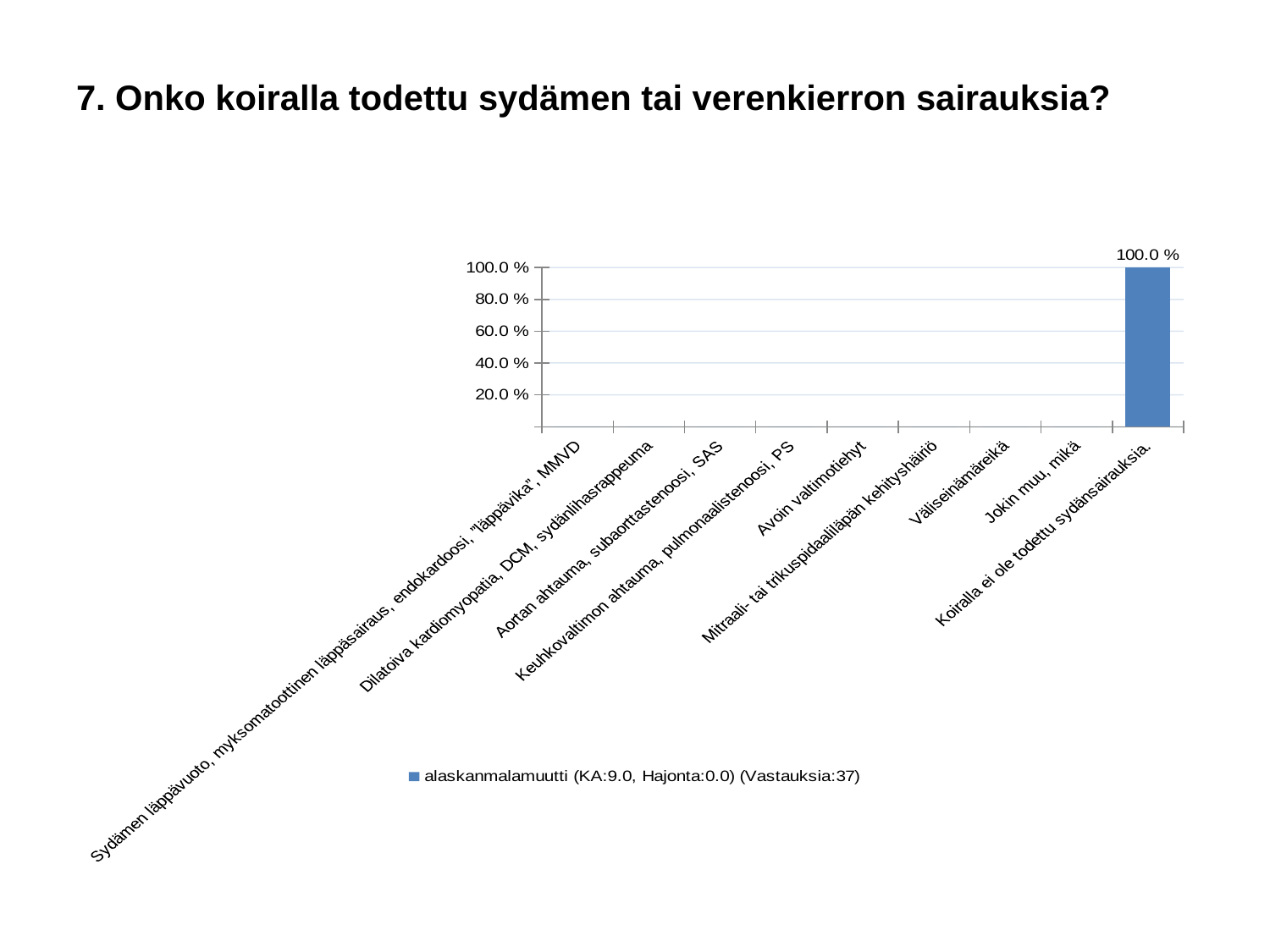
What kind of chart is shown on the slide? bar chart Which is larger, the value for "Koiralla ei ole todettu sydänsairauksia." or the value for "Jokin muu, mikä"? Koiralla ei ole todettu sydänsairauksia. Is the value for "Koiralla ei ole todettu sydänsairauksia." greater or less than 80.0 %? greater What is the title of the slide? 7. Onko koiralla todettu sydämen tai verenkierron sairauksia? What is the highest tick value shown on the y axis? 100.0 % Which category has the highest value? Koiralla ei ole todettu sydänsairauksia. How many categories are shown on the x axis? 9 Is the value for "Väliseinämäreikä" greater or less than 20.0 %? less What is the legend entry of the chart? alaskanmalamuutti (KA:9.0, Hajonta:0.0) (Vastauksia:37) What is the value for "Koiralla ei ole todettu sydänsairauksia."? 100.0 % Is the value for "Avoin valtimotiehyt" greater or less than 20.0 %? less How many series does the legend list? 1